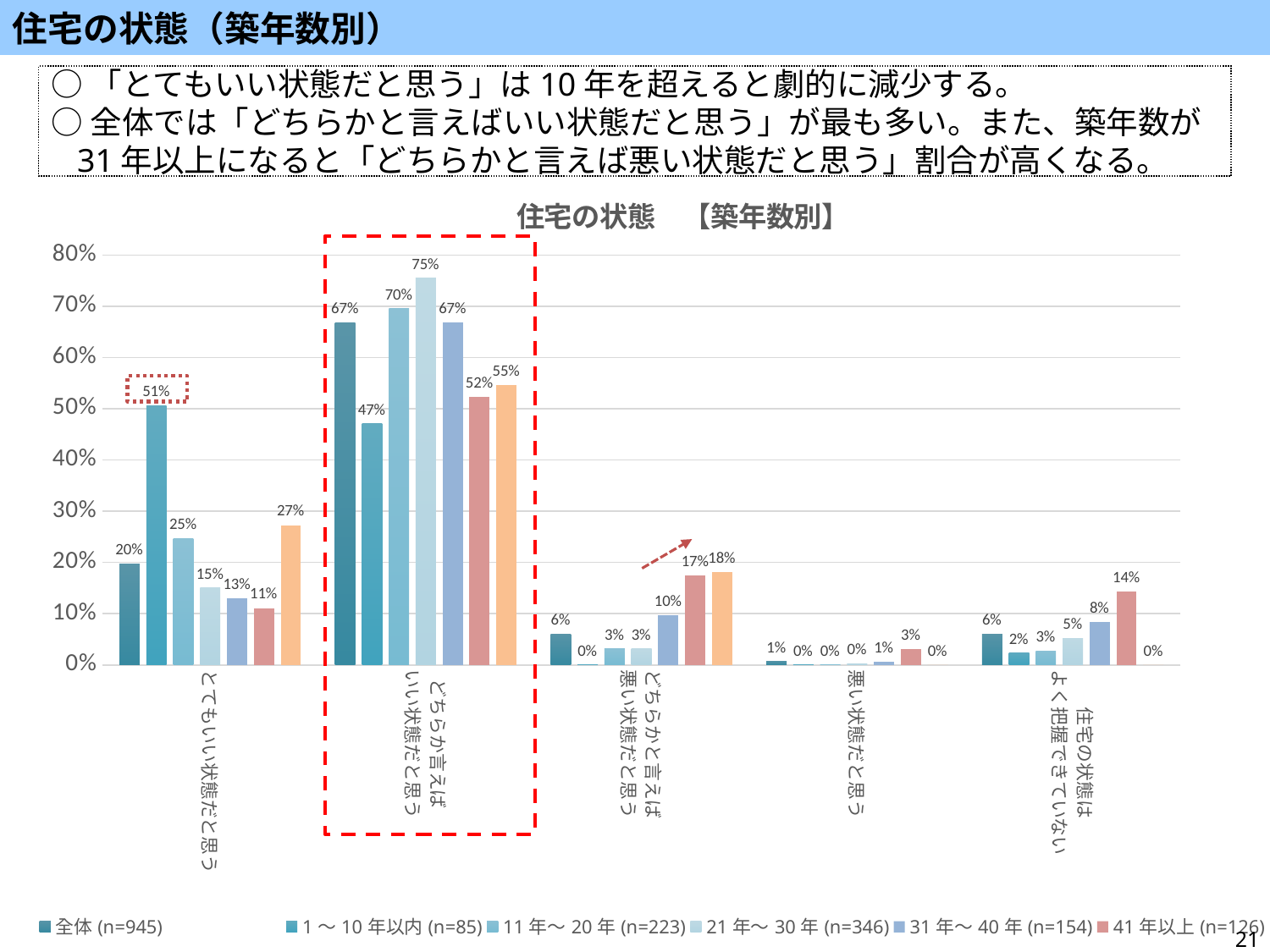
Which age group has the highest value in the category どちらかと言えばいい状態だと思う? 21年～30年 (n=346) What type of chart is shown on the slide? bar chart In the category 住宅の状態はよく把握できていない, which is larger: the value for 41年以上 (n=126) or the value for 全体 (n=945)? 41年以上 (n=126) Which age group has the lowest value in the category どちらかと言えばいい状態だと思う? 1～10年以内 (n=85) How many response categories are shown on the x axis? 5 What is the value for 21年～30年 (n=346) in the category どちらかと言えばいい状態だと思う? 75% What is the difference between the 1～10年以内 (n=85) value and the 11年～20年 (n=223) value in the category とてもいい状態だと思う? 26% What is the value for 全体 (n=945) in the category とてもいい状態だと思う? 20% What is the value for 1～10年以内 (n=85) in the category とてもいい状態だと思う? 51% What is the title of the chart? 住宅の状態 【築年数別】 What is the value for 41年以上 (n=126) in the category どちらかと言えば悪い状態だと思う? 17% What is the value for 31年～40年 (n=154) in the category 住宅の状態はよく把握できていない? 8%